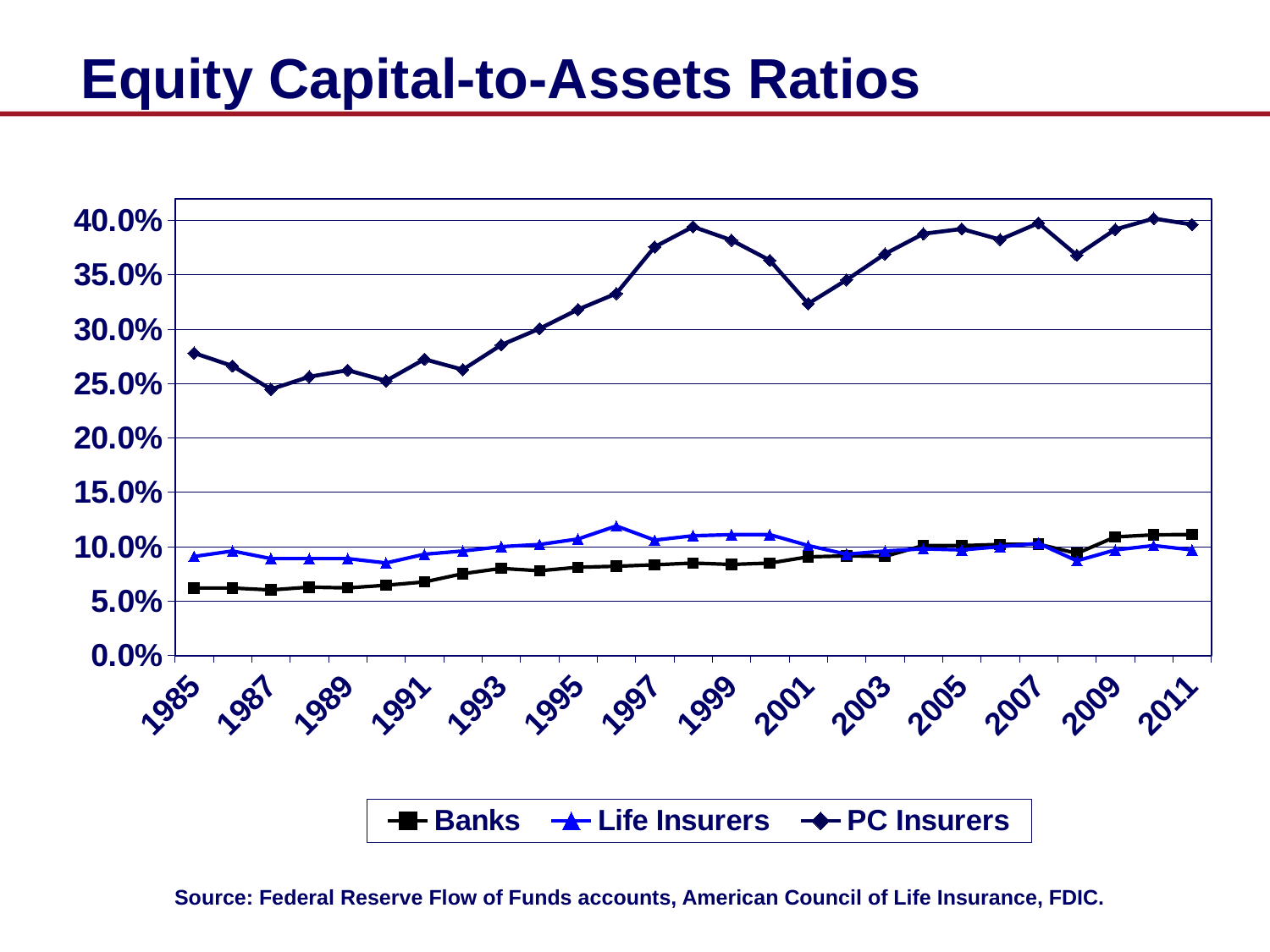
How many series does the legend list? 3 Is the value for Banks in 1985 greater or less than 10%? less In 1985, which is higher: Banks or Life Insurers? Life Insurers Is the value for PC Insurers in 1985 greater or less than 25%? greater Do the values for Banks rise or fall from 1985 to 2011? rise What is the title of the chart? Equity Capital-to-Assets Ratios Which series has the highest equity capital-to-assets ratio across the whole period? PC Insurers Is the value for PC Insurers in 1997 greater or less than 35%? greater Which series has the lowest value in 1985? Banks What kind of chart is shown on the slide? line chart